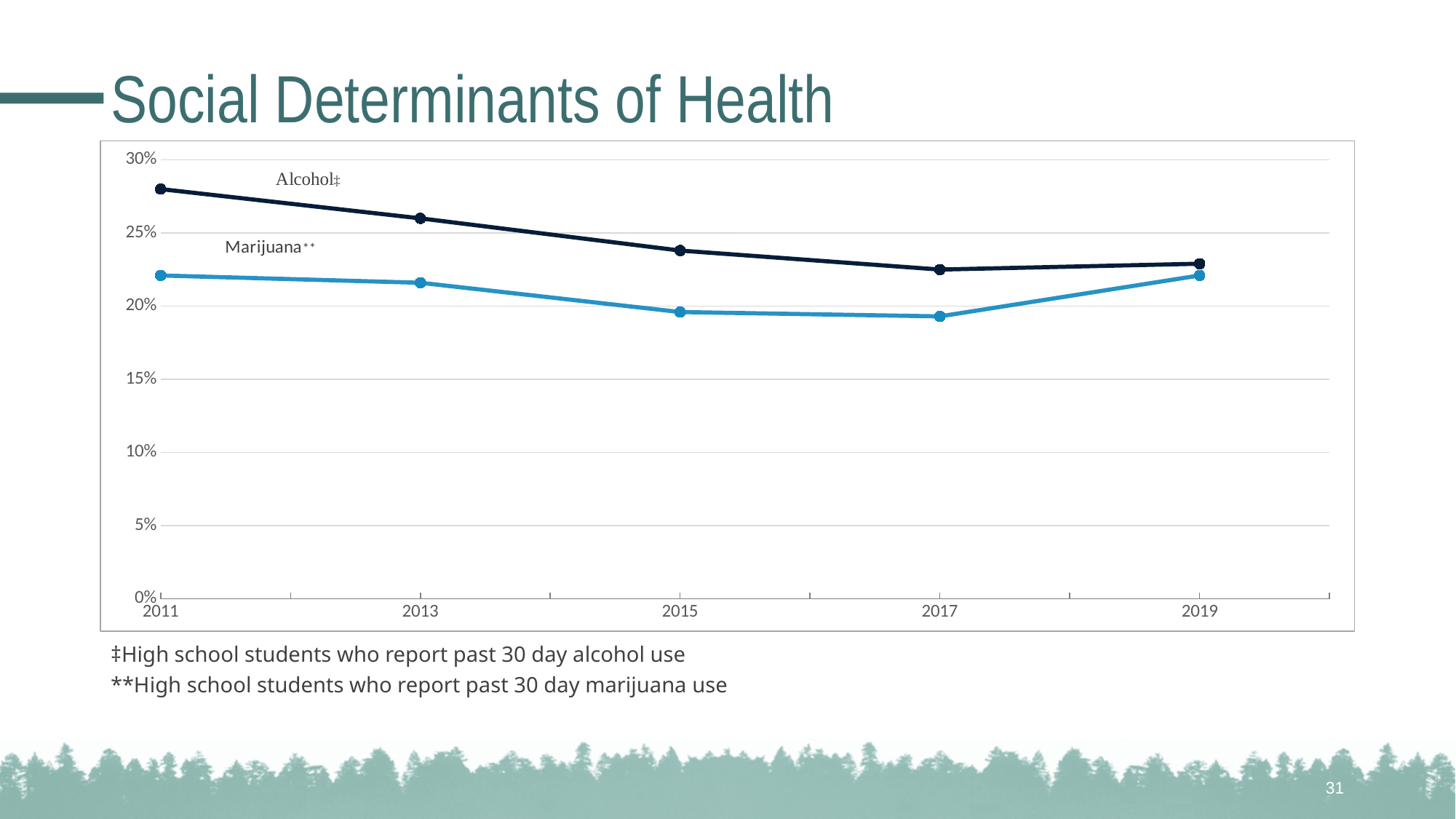
Does the Alcohol series rise or fall from 2011 to 2017? Fall Is the Alcohol value for 2011 greater or less than 25%? greater How many years are plotted along the x axis of the chart? 5 How many data series are plotted in the chart? 2 What kind of chart is shown on the slide? Line chart In 2011, which series has the higher value, Alcohol or Marijuana? Alcohol Which two series are labelled on the chart? Alcohol and Marijuana Is the Marijuana value for 2011 greater or less than 20%? greater According to the footnote, what does the Alcohol series measure? High school students who report past 30 day alcohol use Is the Marijuana value for 2015 greater or less than 20%? less In which year is the Alcohol series at its highest? 2011